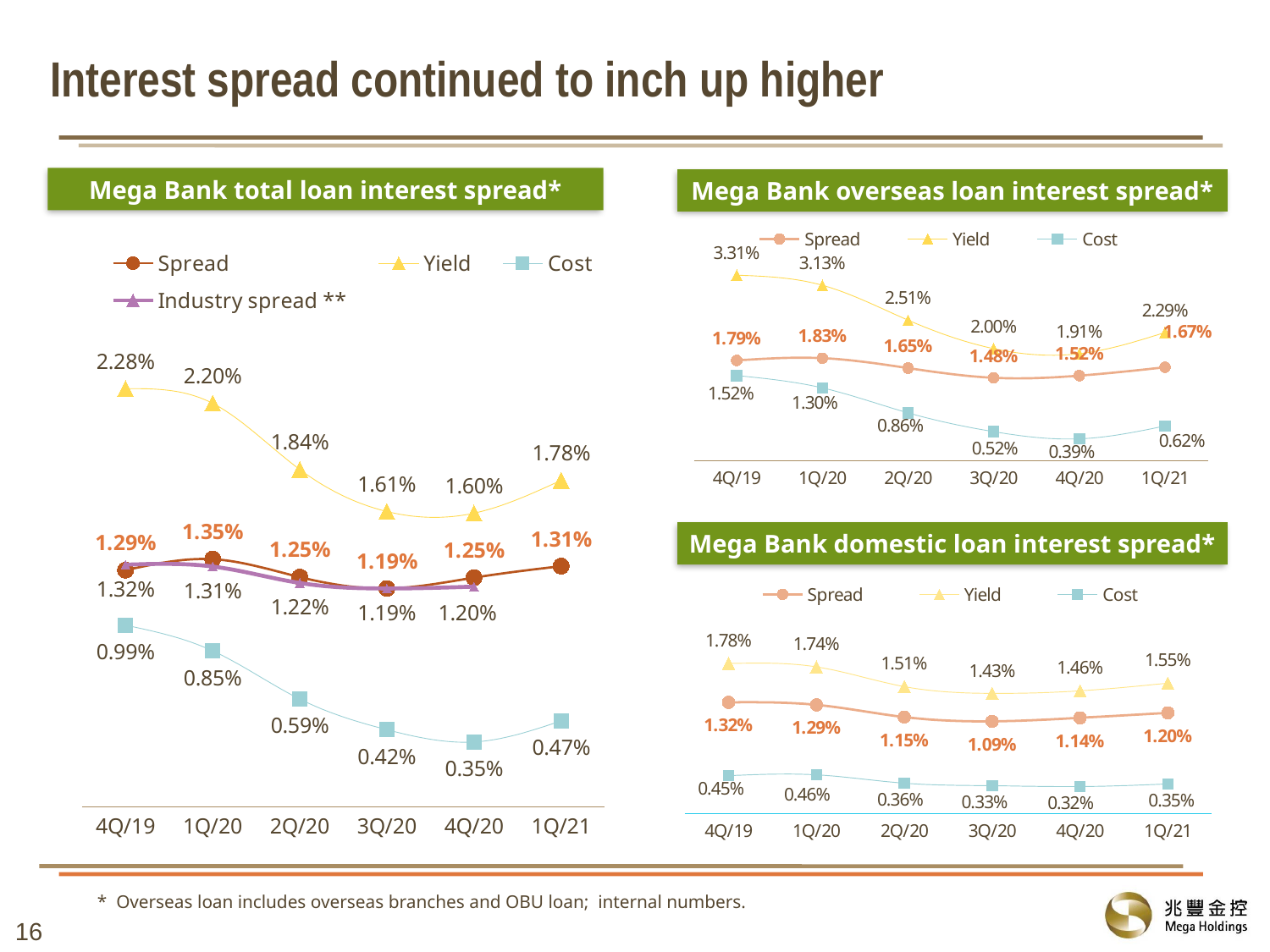
In the 'Mega Bank total loan interest spread*' chart, what is the Yield value for 4Q/19? 2.28% In the 'Mega Bank domestic loan interest spread*' chart, how many quarters are shown on the x axis? 6 In the 'Mega Bank overseas loan interest spread*' chart, what is the Cost value for 4Q/20? 0.39% In the 'Mega Bank total loan interest spread*' chart, what is the Spread value for 1Q/21? 1.31% In the 'Mega Bank overseas loan interest spread*' chart, does the Yield rise or fall from 4Q/19 to 3Q/20? Fall In the 'Mega Bank overseas loan interest spread*' chart, in which quarter is the Spread highest? 1Q/20 In the 'Mega Bank total loan interest spread*' chart, how many series does the legend list? 4 In the 'Mega Bank total loan interest spread*' chart, in which quarter is the Cost lowest? 4Q/20 In the 'Mega Bank overseas loan interest spread*' chart, what kind of chart is shown? Line chart In the 'Mega Bank domestic loan interest spread*' chart, what is the Spread value for 3Q/20? 1.09% In the 'Mega Bank total loan interest spread*' chart, what is the difference between the Yield and the Cost in 1Q/21? 1.31% In the 'Mega Bank domestic loan interest spread*' chart, which is larger, the Yield in 4Q/19 or the Yield in 1Q/21? 4Q/19